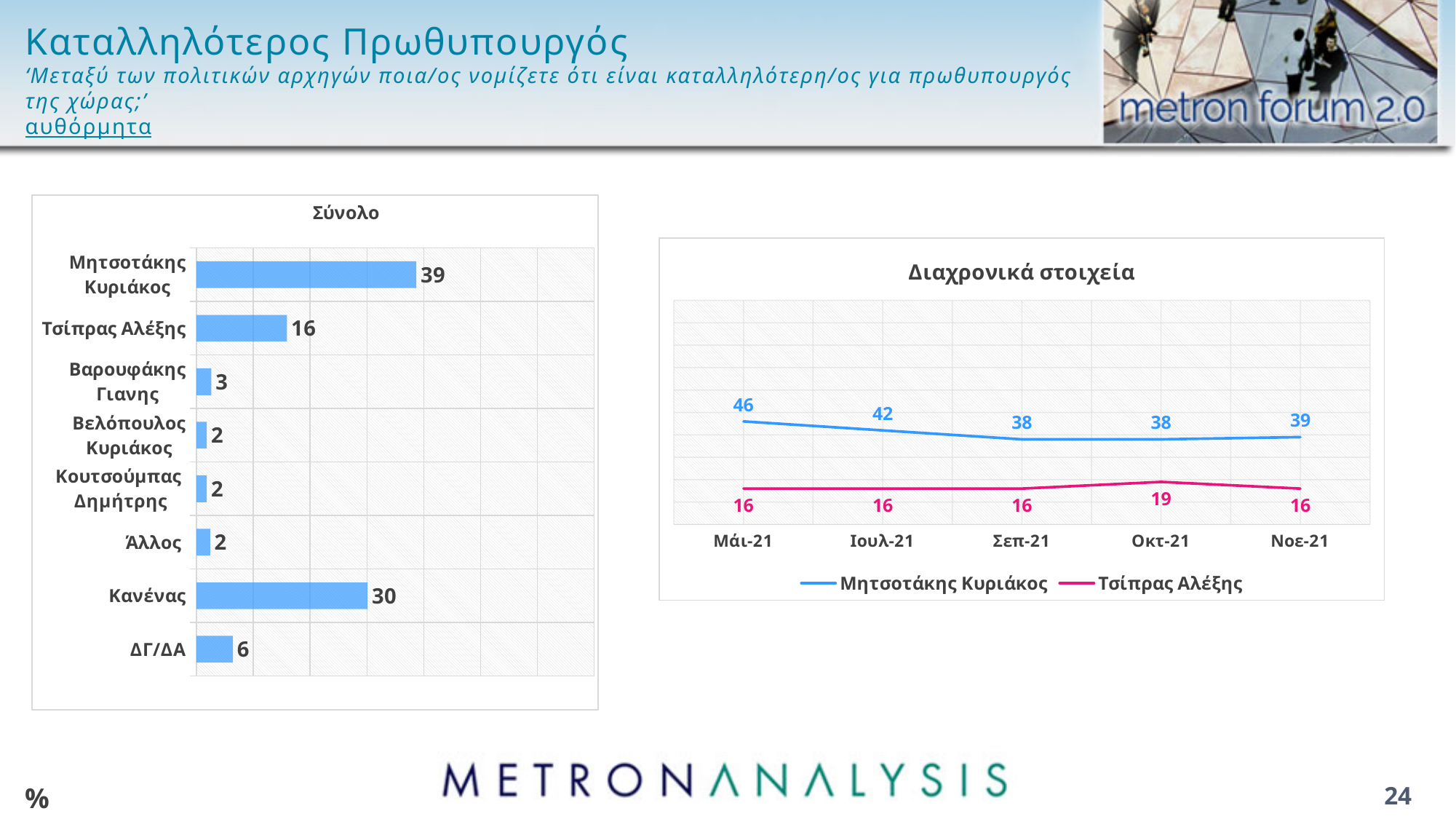
In the 'Σύνολο' chart, what is the value for Μητσοτάκης Κυριάκος? 39 In the 'Σύνολο' chart, which category has the highest value? Μητσοτάκης Κυριάκος In the 'Σύνολο' chart, what is the difference between Μητσοτάκης Κυριάκος and Τσίπρας Αλέξης? 23 In the 'Σύνολο' chart, which is larger: the value for Κανένας or the value for Τσίπρας Αλέξης? Κανένας In the 'Διαχρονικά στοιχεία' chart, what is the value for Μητσοτάκης Κυριάκος in Μάι-21? 46 What kind of chart is the 'Σύνολο' chart? bar chart How many categories are shown in the 'Σύνολο' chart? 8 In the 'Διαχρονικά στοιχεία' chart, does the Μητσοτάκης Κυριάκος line rise or fall from Μάι-21 to Σεπ-21? fall In the 'Διαχρονικά στοιχεία' chart, how many series does the legend list? 2 In the 'Διαχρονικά στοιχεία' chart, what is the value for Τσίπρας Αλέξης in Οκτ-21? 19 In the 'Σύνολο' chart, what is the value for Κανένας? 30 In the 'Διαχρονικά στοιχεία' chart, what is the difference between Μητσοτάκης Κυριάκος and Τσίπρας Αλέξης in Νοε-21? 23